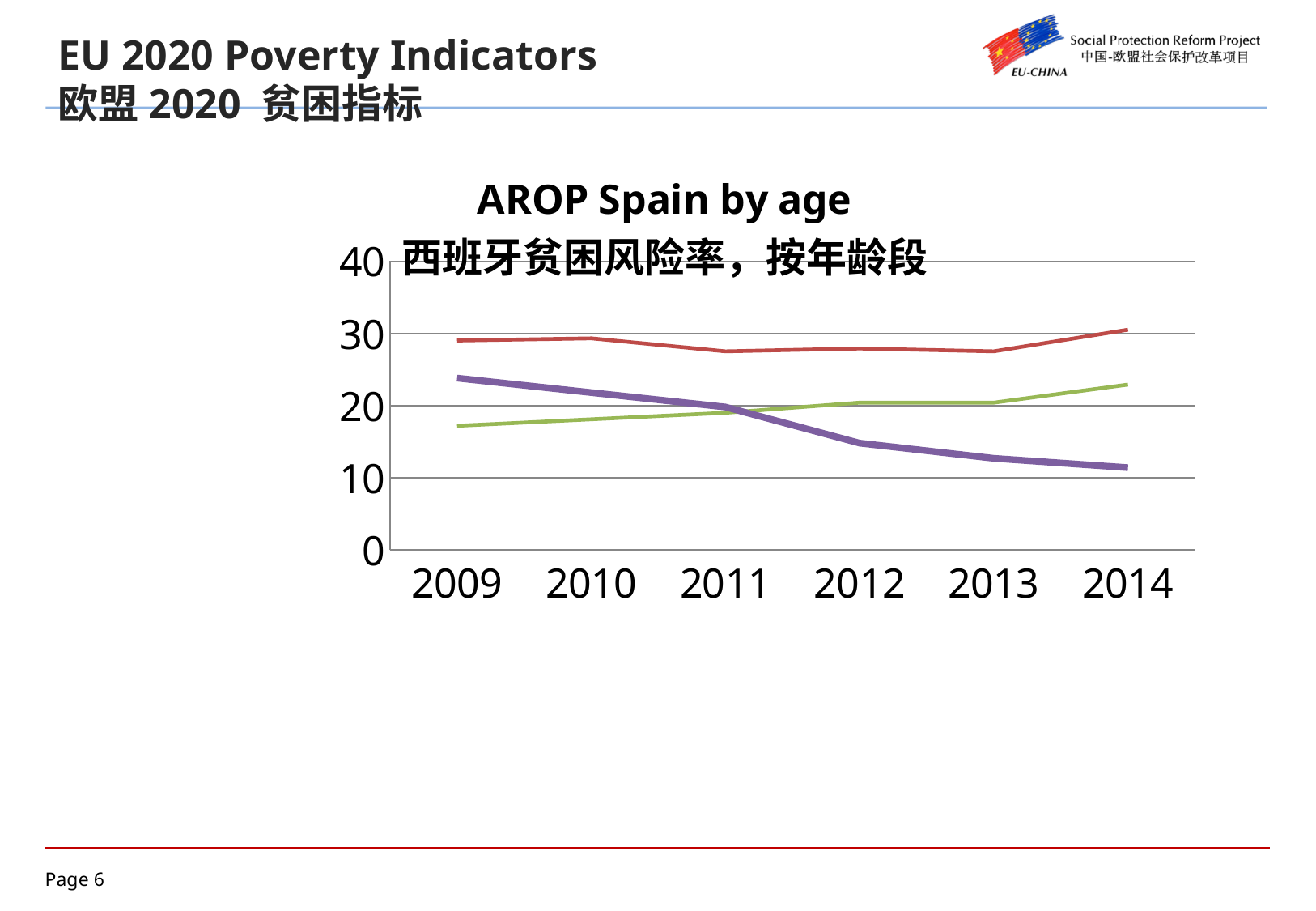
Is the value of the green line in 2009 greater or less than 20? less Is the value of the red line in 2011 greater or less than 30? less Does the purple line rise or fall from 2009 to 2014? fall In 2014, which line has the higher value, the green line or the purple line? green line Is the value of the purple line in 2014 greater or less than 20? less How many years are shown on the x axis of the chart? 6 What is the English title of the chart? AROP Spain by age Does the green line rise or fall from 2009 to 2014? rise In 2009, which line has the higher value, the purple line or the green line? purple line How many lines are plotted on the chart? 3 What kind of chart is shown on the slide? line chart